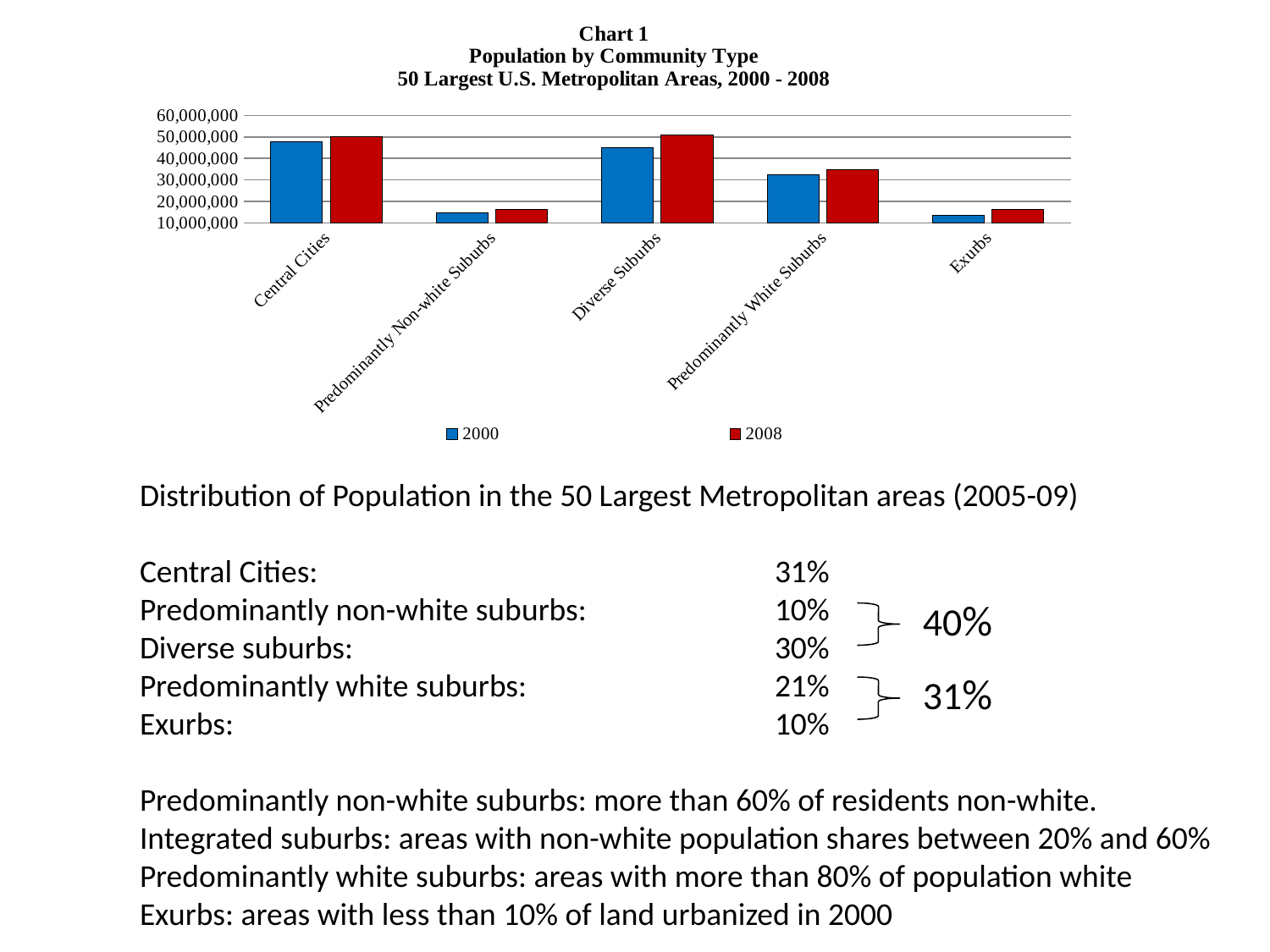
Is the 2000 value for Exurbs greater or less than 20,000,000? less For Diverse Suburbs, which year has the larger value: 2000 or 2008? 2008 Which is larger for the year 2000: Central Cities or Predominantly White Suburbs? Central Cities Is the 2008 value for Predominantly White Suburbs greater or less than 40,000,000? less Which years are listed in the chart's legend? 2000 and 2008 How many community type categories are shown on the x axis of the chart? 5 Which colour represents the 2008 series in the chart? red What kind of chart is shown on the slide? bar chart How many series does the chart's legend list? 2 Which is larger for the year 2008: Exurbs or Predominantly White Suburbs? Predominantly White Suburbs Is the 2008 value for Diverse Suburbs greater or less than 40,000,000? greater